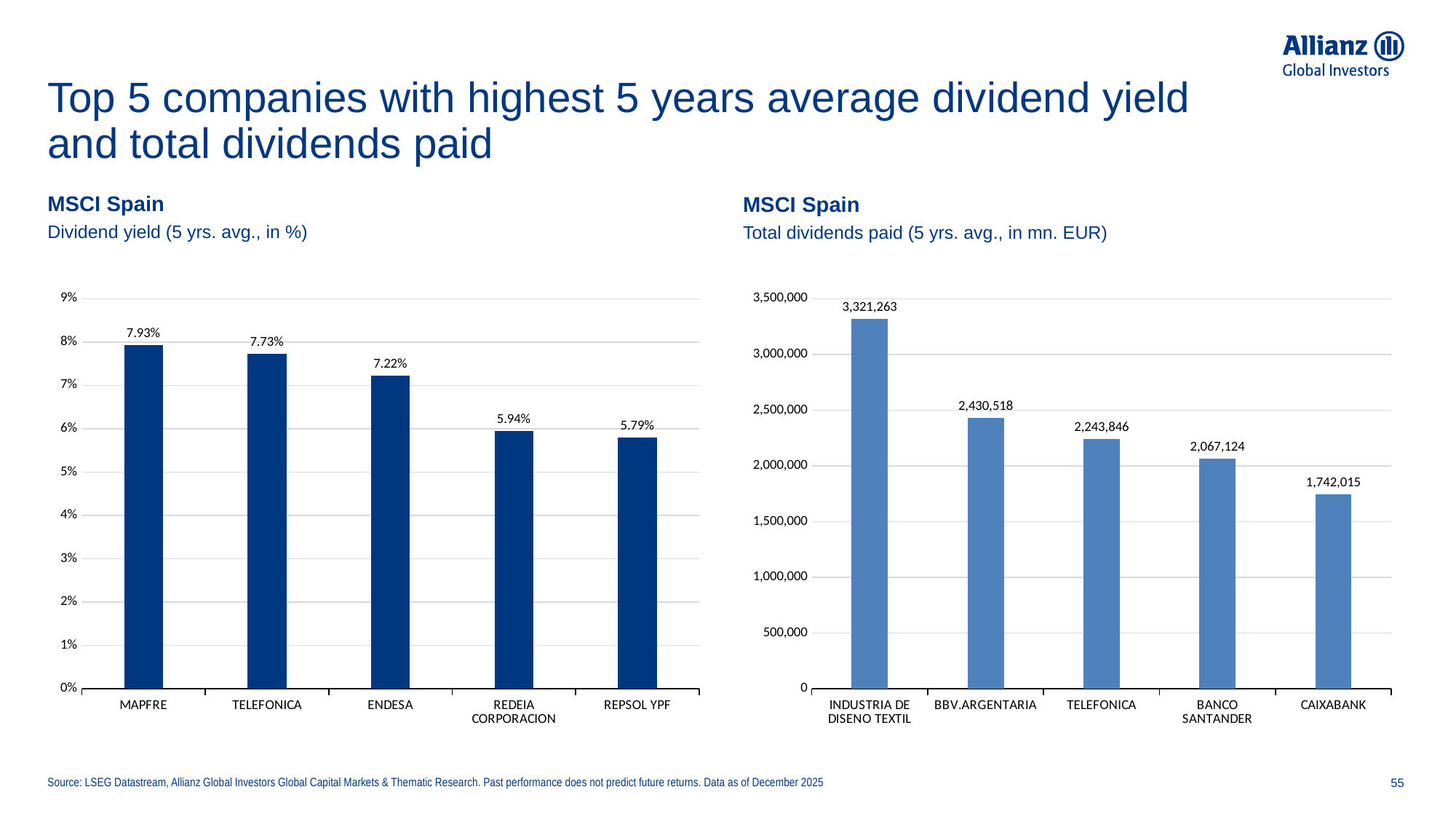
In the right chart (Total dividends paid), which is larger, the value for BBV.ARGENTARIA or the value for TELEFONICA? BBV.ARGENTARIA In the right chart (Total dividends paid), what is the difference between the values for INDUSTRIA DE DISENO TEXTIL and CAIXABANK? 1,579,248 In the left chart (Dividend yield), what is the difference between the values for MAPFRE and TELEFONICA? 0.20% What kind of chart is the right chart (Total dividends paid)? bar chart In the left chart (Dividend yield), what is the value for ENDESA? 7.22% In the right chart (Total dividends paid), which company has the highest total dividends paid? INDUSTRIA DE DISENO TEXTIL In the left chart (Dividend yield), which company has the lowest dividend yield? REPSOL YPF In the left chart (Dividend yield), which company has the highest dividend yield? MAPFRE In the right chart (Total dividends paid), which company has the lowest total dividends paid? CAIXABANK In the left chart (Dividend yield), do the values rise or fall from left to right? fall In the right chart (Total dividends paid), what is the value for BANCO SANTANDER? 2,067,124 In the left chart (Dividend yield), how many companies are shown? 5